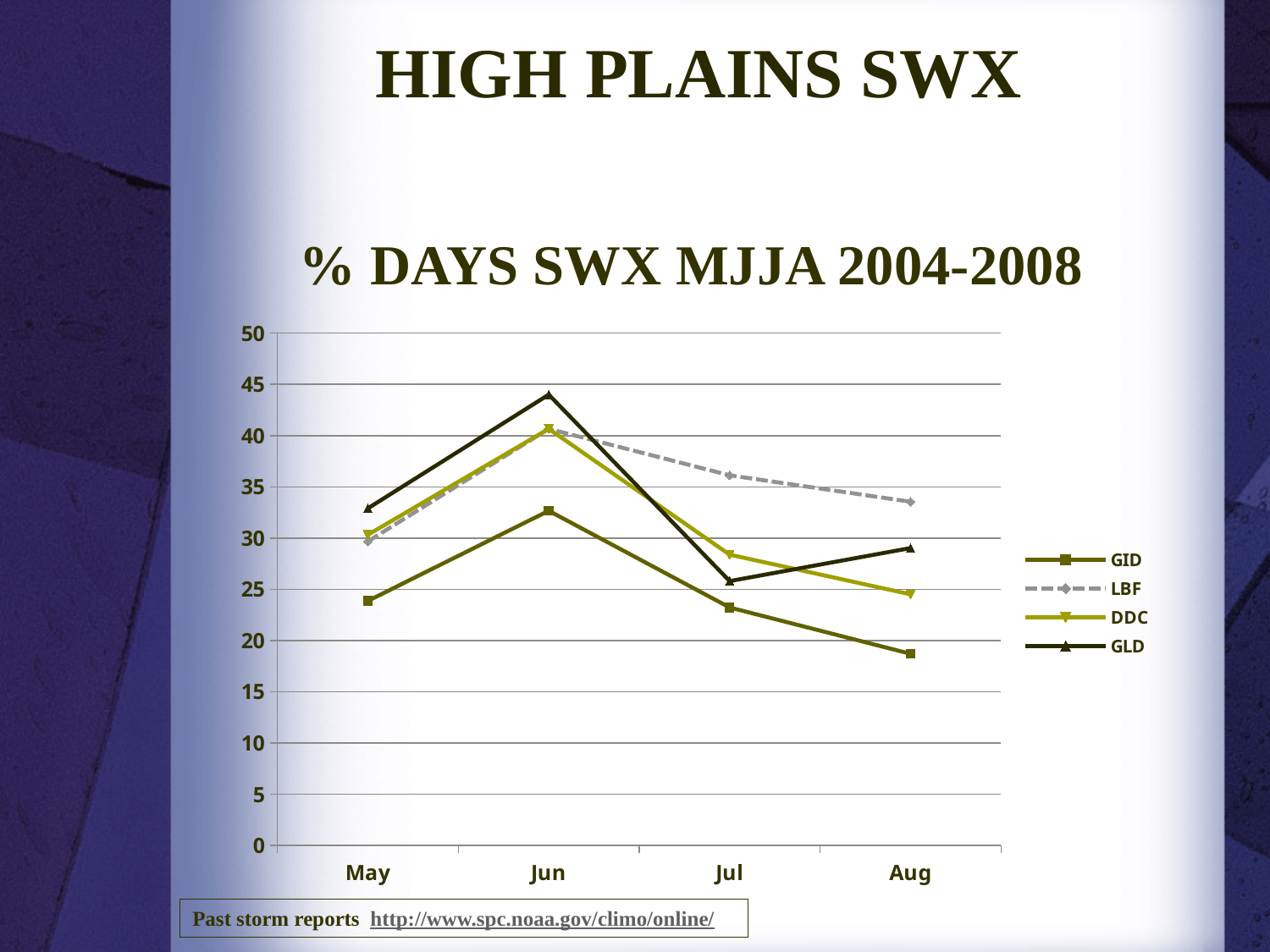
Is the value for GID in Aug greater or less than 20? less How many months are shown on the x axis? 4 Does the GID series rise or fall from Jun to Aug? fall What kind of chart is shown on the slide? line chart Which series has the highest value in Jun? GLD What is the title of the chart? % DAYS SWX MJJA 2004-2008 Is the value for LBF in Jul greater or less than 35? greater How many series does the legend list? 4 Is the value for GLD in Jun greater or less than 40? greater In Jul, which series has the larger value, DDC or GLD? DDC Which series has the lowest value in Aug? GID In Aug, which series has the larger value, LBF or DDC? LBF